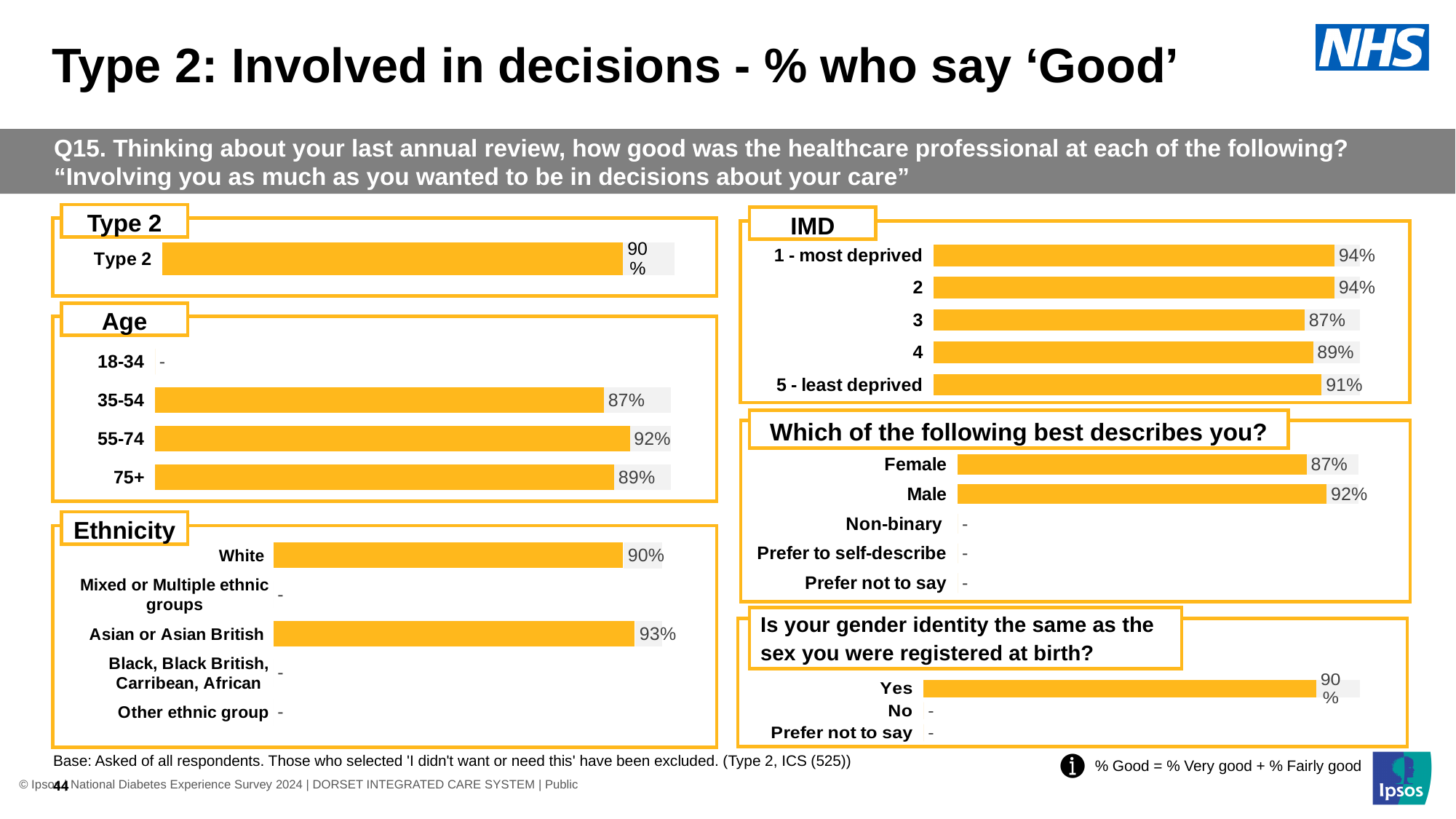
In the Age chart, what is the difference between the 55-74 and 35-54 values? 5 percentage points In the IMD chart, how many categories are shown? 5 In the Age chart, which age group with a plotted value has the lowest percentage? 35-54 In the 'Is your gender identity the same as the sex you were registered at birth?' chart, what is the value for Yes? 90% In the Type 2 chart, what percentage of Type 2 respondents say 'Good'? 90% In the Age chart, what is the value for the 55-74 age group? 92% In the IMD chart, which category has the lowest value? 3 In the 'Which of the following best describes you?' chart, what is the difference between Male and Female? 5 percentage points In the Ethnicity chart, what is the value for Asian or Asian British? 93% In the IMD chart, what is the value for 3? 87% In the Ethnicity chart, which is higher: White or Asian or Asian British? Asian or Asian British In the 'Which of the following best describes you?' chart, what is the value for Male? 92%